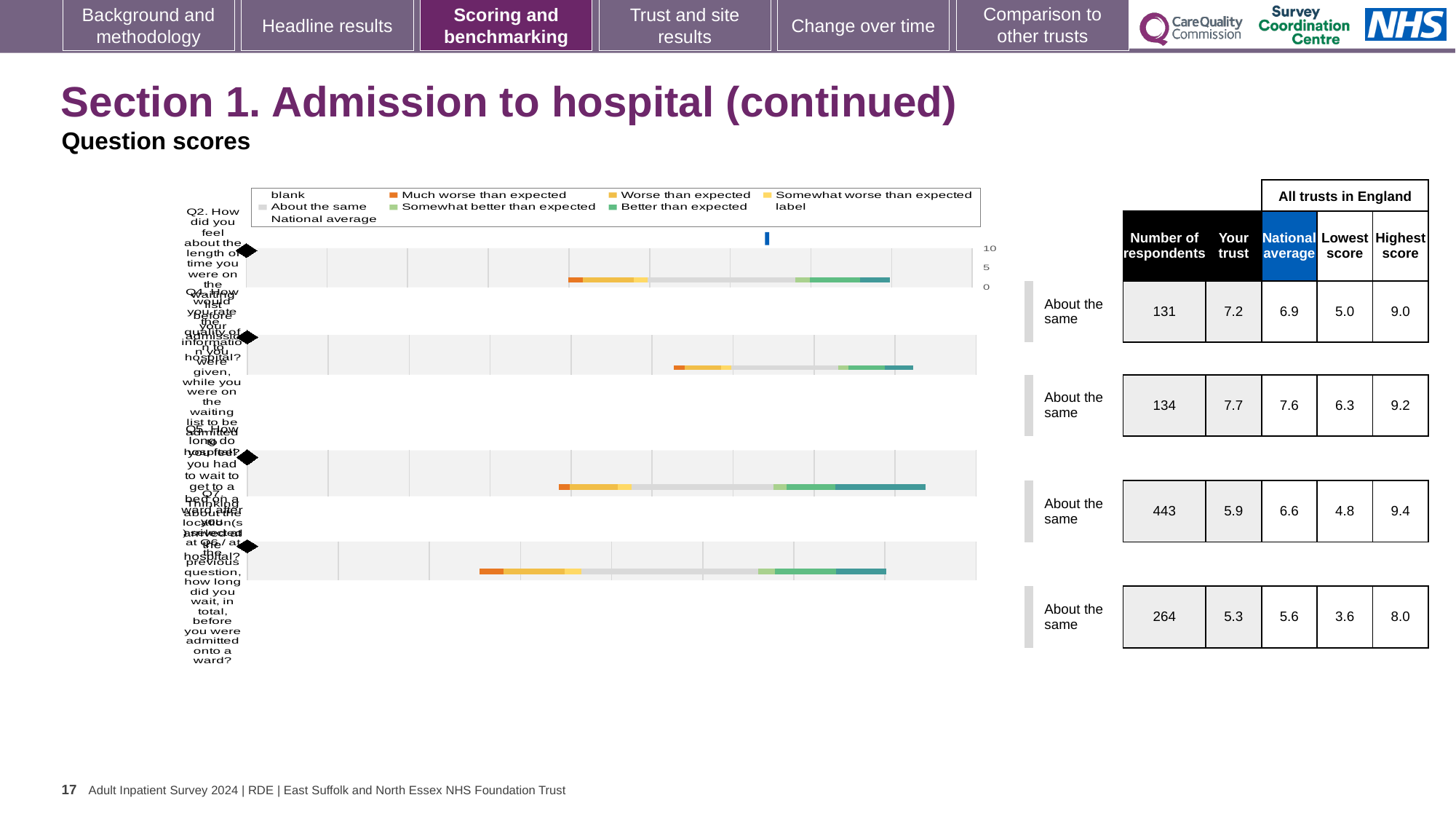
How many question bars are plotted in the chart? 4 In the table next to the chart, what is the national average for the row with 443 respondents? 6.6 In the table next to the chart, what is the highest score for the row with 264 respondents? 8.0 In the table next to the chart, what is the 'Your trust' score for the row with 131 respondents? 7.2 Which row in the table has the lowest 'Your trust' score? the row with 264 respondents (5.3) Which legend entry is shown in orange? Much worse than expected What kind of chart is shown on the slide? bar chart In the table next to the chart, what is the lowest score for the row with 134 respondents? 6.3 Which row in the table has the highest 'Your trust' score? the row with 134 respondents (7.7) For the row with 443 respondents, what is the difference between the national average and the 'Your trust' score? 0.7 For the row with 131 respondents, is the 'Your trust' score higher or lower than the national average? higher What benchmark label is shown beside each of the four question bars? About the same